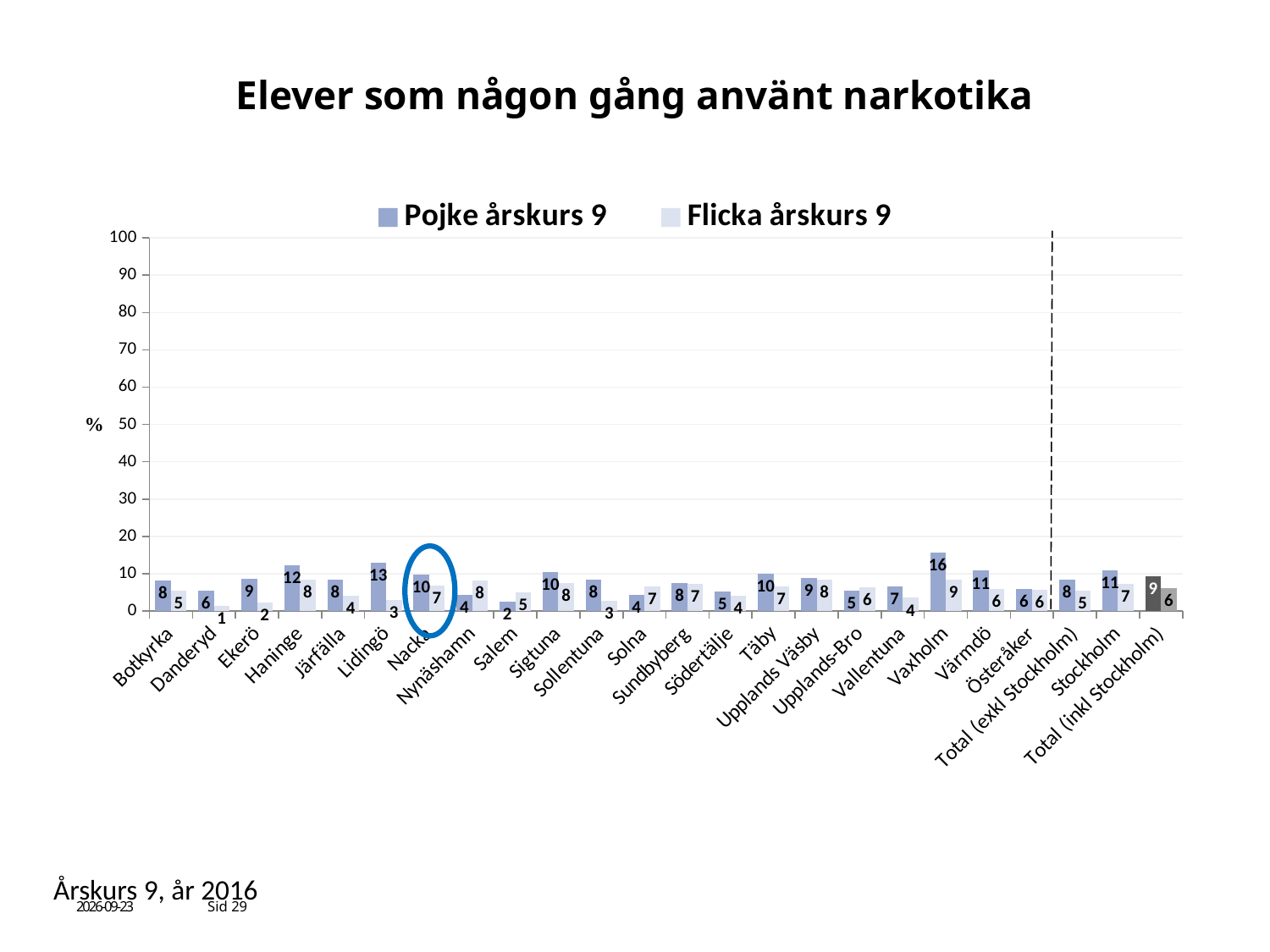
What is the value for Flicka årskurs 9 in Danderyd? 1 What is the title of the chart? Elever som någon gång använt narkotika What is the difference between the Pojke årskurs 9 and Flicka årskurs 9 values in Lidingö? 10 Which municipality has the highest value for Pojke årskurs 9? Vaxholm What is the value for Pojke årskurs 9 in Vaxholm? 16 Is the value for Pojke årskurs 9 in Vaxholm greater or less than 20? less How many categories are shown on the x axis? 24 Which category has the lowest value for Pojke årskurs 9? Salem What kind of chart is shown on the slide? bar chart What is the value for Pojke årskurs 9 in Nacka? 10 Which is larger in Nynäshamn, the Pojke årskurs 9 value or the Flicka årskurs 9 value? Flicka årskurs 9 How many series does the legend list? 2